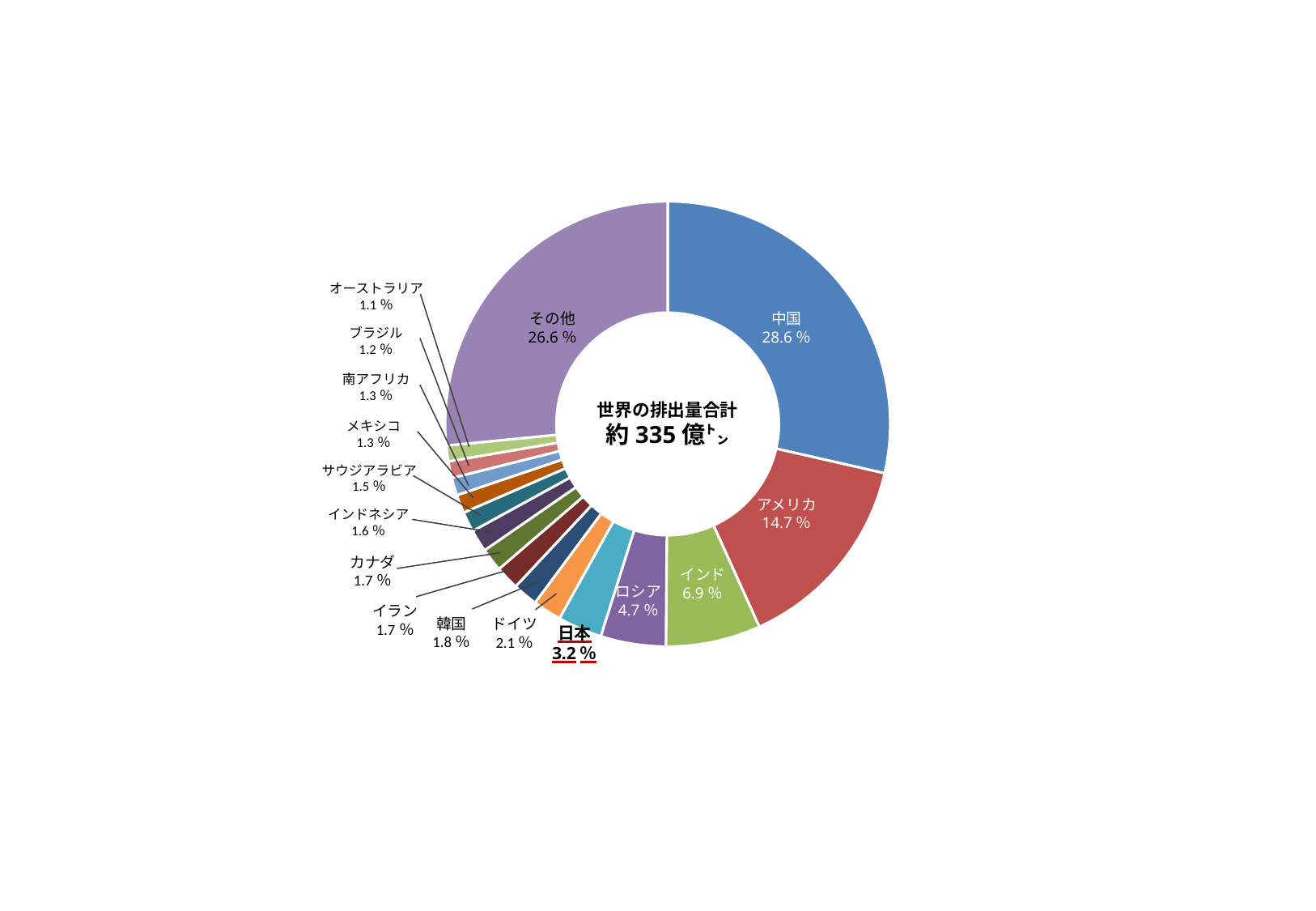
What total is written in the centre of the donut chart? 約 335 億トン What is the value shown for ロシア? 4.7 % Which is larger, the share of インド or the share of ロシア? インド What is the difference between the shares of ドイツ and 韓国? 0.3 % What share of the pie does 中国 account for? 28.6 % What is the value shown for オーストラリア? 1.1 % Which slice has the smallest share? オーストラリア Which named country has the largest slice of the pie? 中国 What is the value shown for 日本? 3.2 % How many slices does the pie chart have? 16 What kind of chart is shown on the slide? Pie chart (donut) What is the difference between the shares of 中国 and アメリカ? 13.9 %